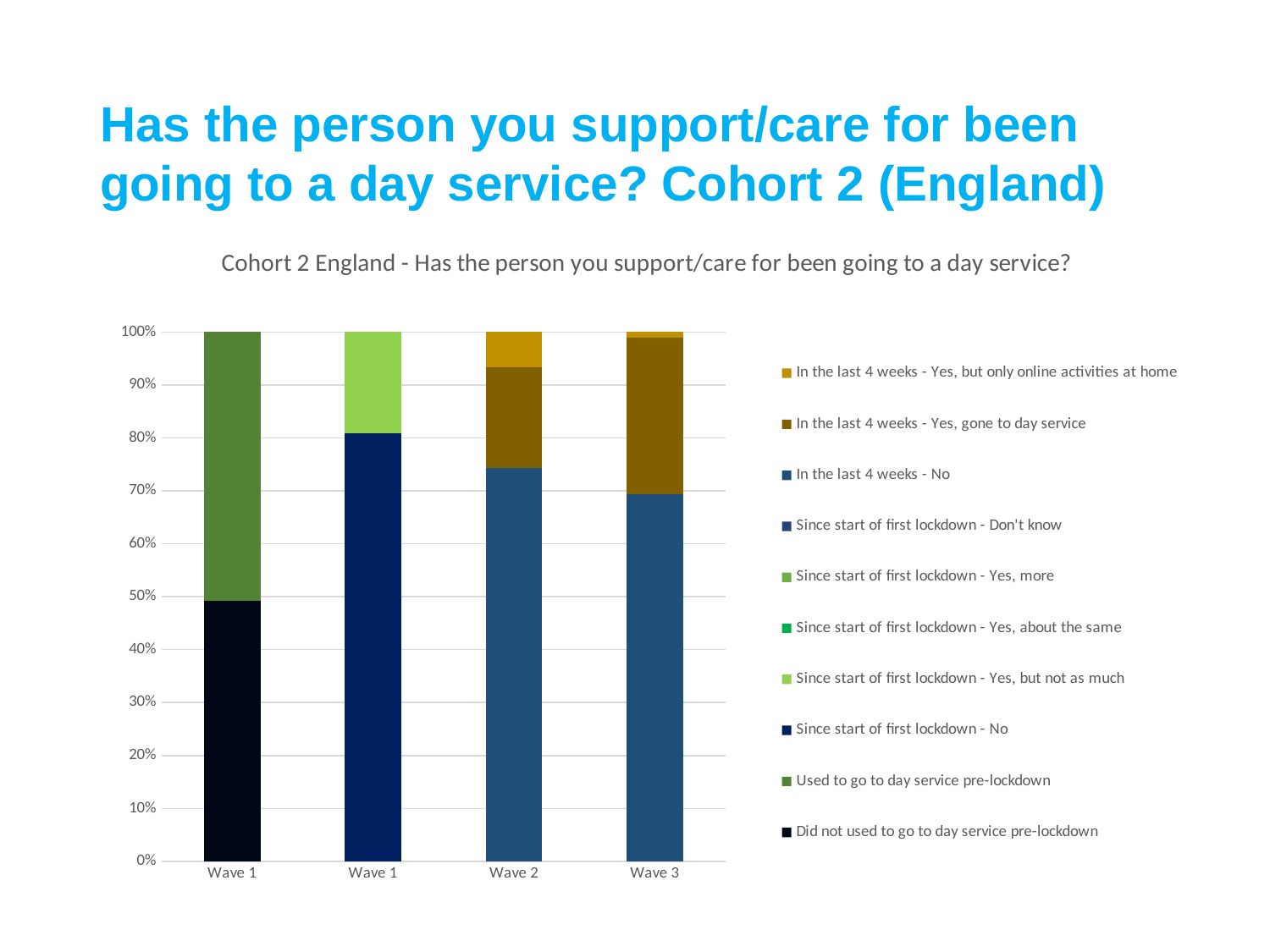
How many bars are plotted on the chart? 4 Does the share for 'In the last 4 weeks - No' rise or fall from Wave 2 to Wave 3? fall Which bar has the larger segment for 'In the last 4 weeks - No', Wave 2 or Wave 3? Wave 2 Which bar has the larger segment for 'In the last 4 weeks - Yes, gone to day service', Wave 2 or Wave 3? Wave 3 What is the title of the chart? Cohort 2 England - Has the person you support/care for been going to a day service? In the Wave 2 bar, is the share for 'In the last 4 weeks - No' greater or less than 70%? greater How many series does the legend list? 10 In the Wave 3 bar, is the share for 'In the last 4 weeks - No' greater or less than 60%? greater What is the label of the x-axis category for the last bar on the right? Wave 3 What kind of chart is shown on the slide? Stacked bar chart